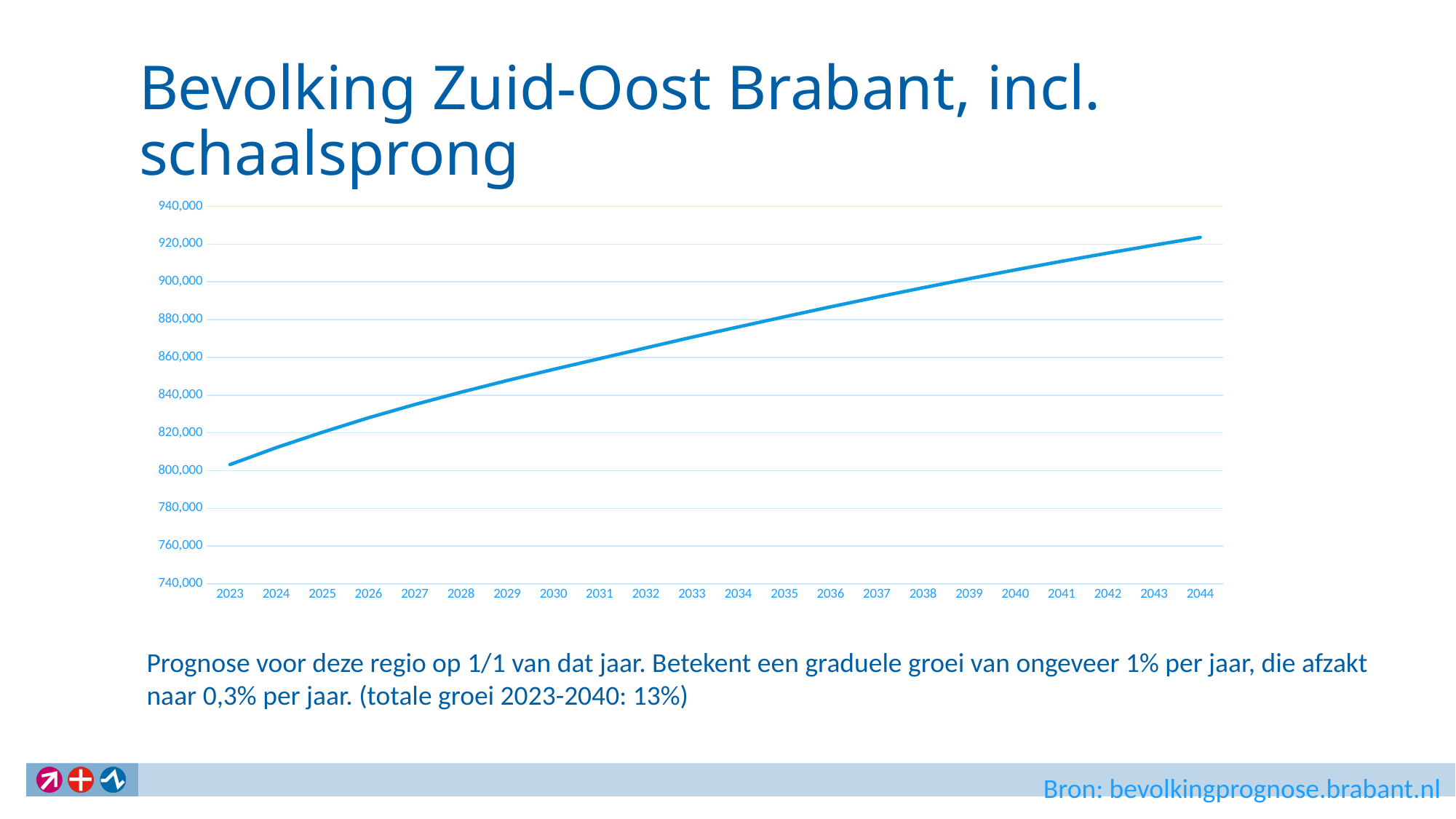
Which is larger, the value for 2030 or the value for 2040? 2040 Do the values rise or fall from 2023 to 2044? rise Is the value for 2035 greater or less than 900,000? less Which year has the highest value? 2044 Which year has the lowest value? 2023 What is the lowest tick label on the y axis? 740,000 Is the value for 2044 greater or less than 900,000? greater What kind of chart is shown on the slide? line chart What is the title of the slide containing the chart? Bevolking Zuid-Oost Brabant, incl. schaalsprong Is the value for 2030 greater or less than 840,000? greater How many years are shown on the x axis? 22